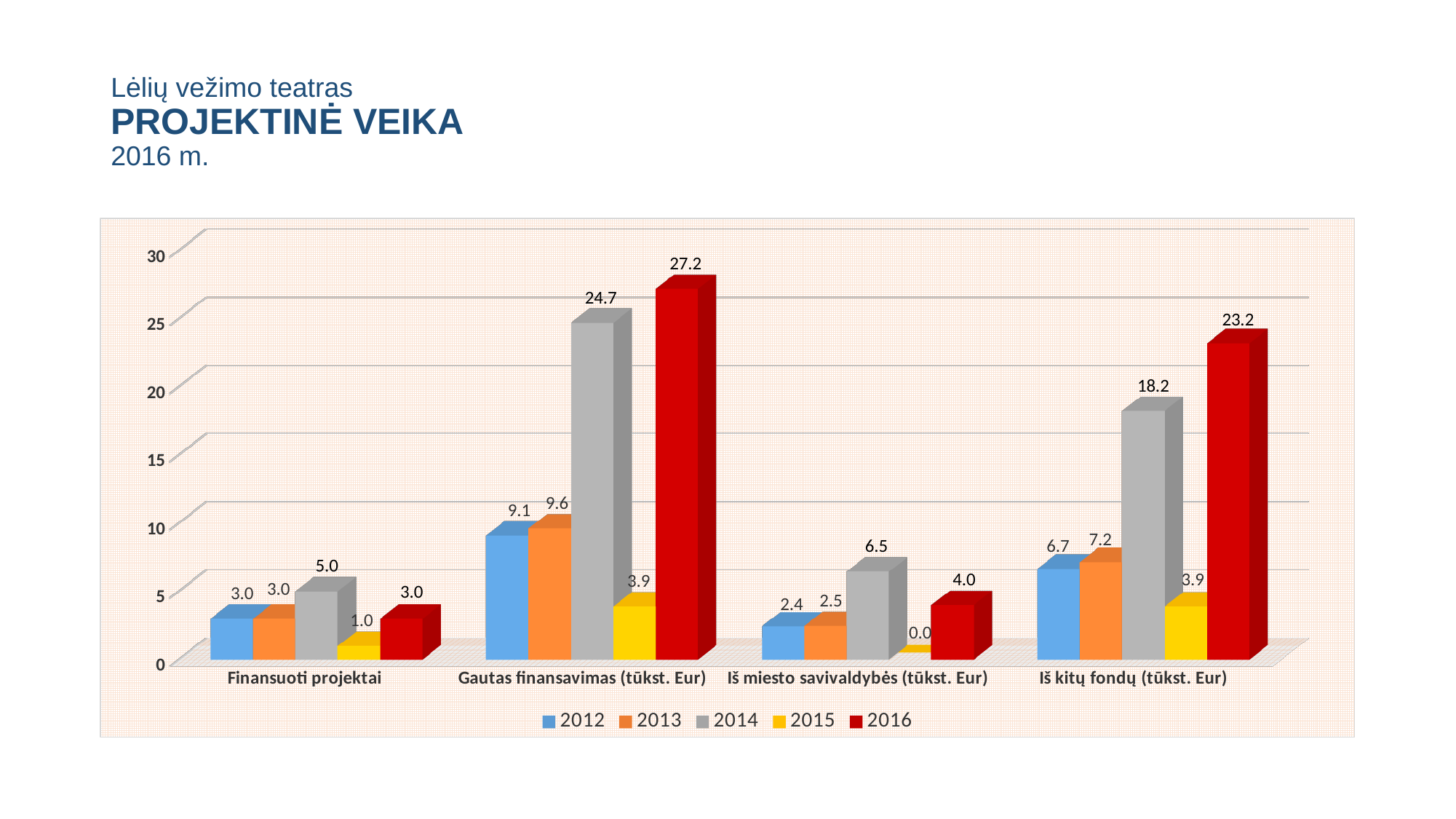
Which is larger in the "Iš miesto savivaldybės (tūkst. Eur)" category: the 2014 value or the 2016 value? 2014 How many categories are shown on the x axis? 4 What is the value for 2014 in the "Iš kitų fondų (tūkst. Eur)" category? 18.2 What kind of chart is shown on the slide? Bar chart How many series does the legend list? 5 Which year has the lowest value in the "Iš kitų fondų (tūkst. Eur)" category? 2015 Which year has the highest value in the "Finansuoti projektai" category? 2014 What is the difference between the 2016 and 2012 values in the "Iš kitų fondų (tūkst. Eur)" category? 16.5 Which colour represents the 2016 series in the legend? Red What is the difference between the 2016 and 2014 values in the "Gautas finansavimas (tūkst. Eur)" category? 2.5 What is the value for 2015 in the "Iš miesto savivaldybės (tūkst. Eur)" category? 0.0 What is the value for 2016 in the "Gautas finansavimas (tūkst. Eur)" category? 27.2